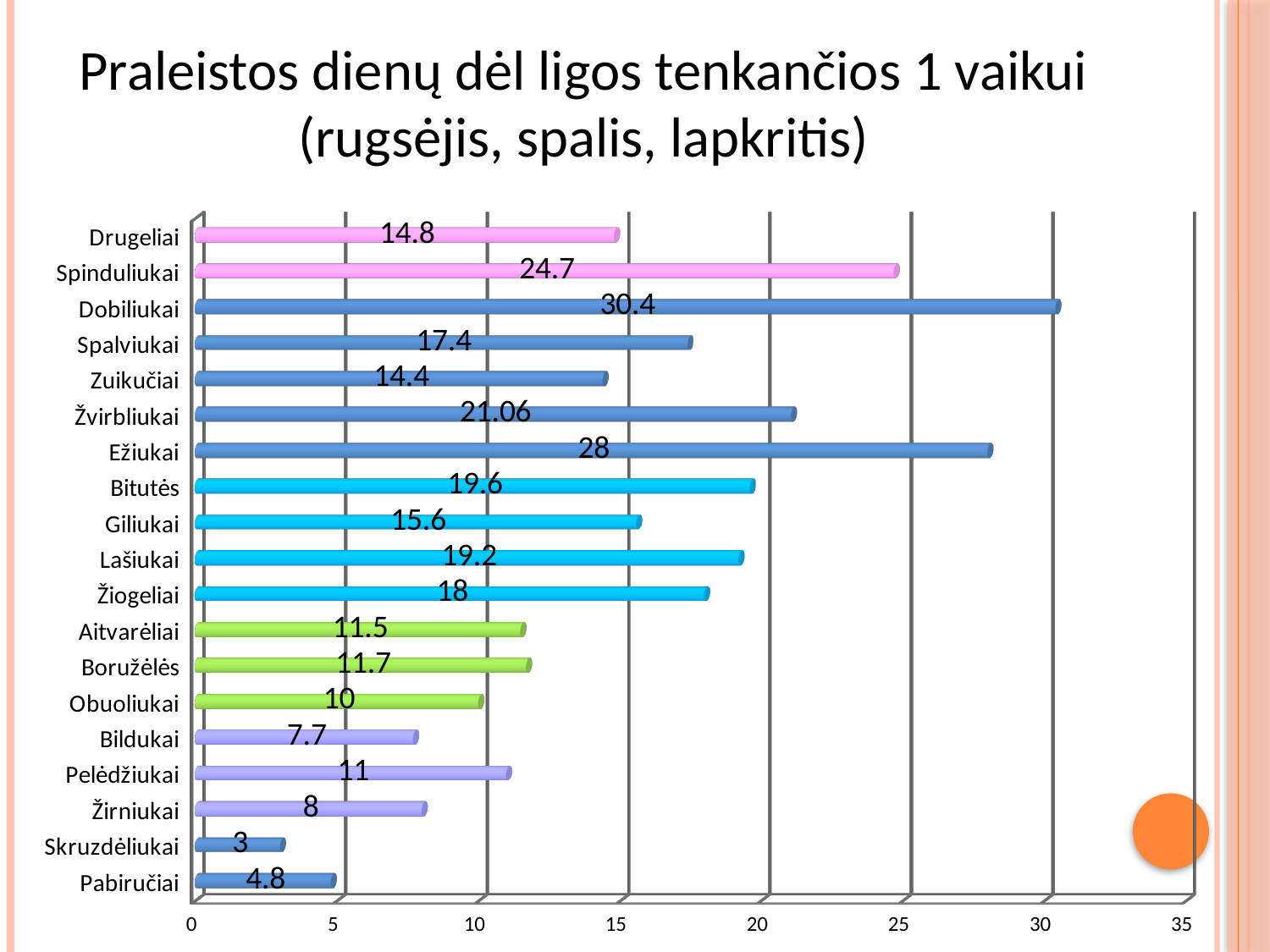
What is the difference between the values for Ežiukai and Spinduliukai? 3.3 Which category has the lowest value? Skruzdėliukai Which is larger, the value for Spalviukai or the value for Giliukai? Spalviukai What is the value for Dobiliukai? 30.4 What kind of chart is shown on the slide? bar chart Which category has the highest value? Dobiliukai Is the value for Žiogeliai greater or less than 15? greater How many categories are shown in the chart? 19 What is the title of the chart on the slide? Praleistos dienų dėl ligos tenkančios 1 vaikui (rugsėjis, spalis, lapkritis) What is the value for Žvirbliukai? 21.06 What is the difference between the values for Bitutės and Lašiukai? 0.4 What is the value for Pabiručiai? 4.8